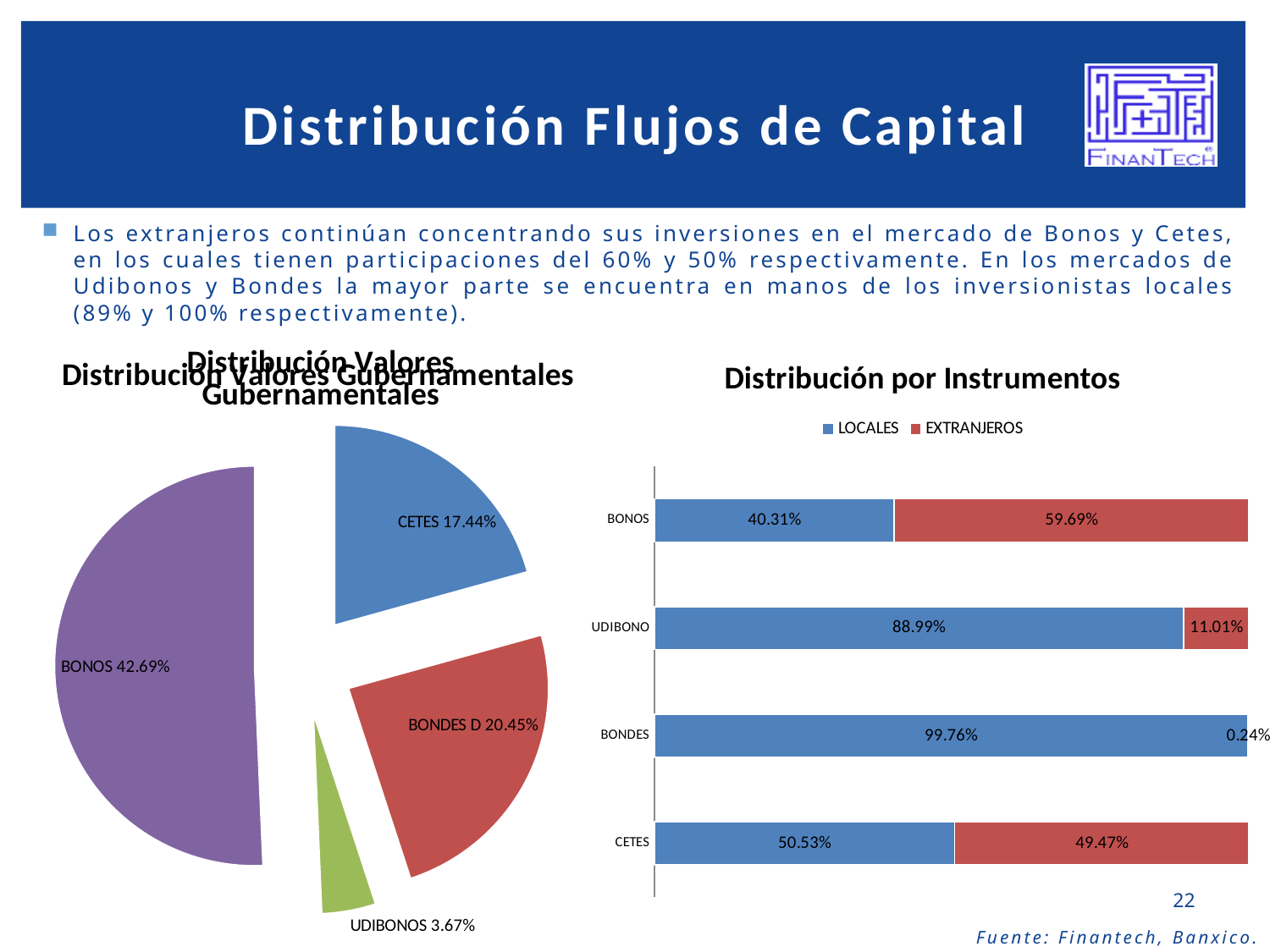
In the 'Distribución por Instrumentos' chart, which instrument has the highest LOCALES value? BONDES In the 'Distribución Valores Gubernamentales' pie chart, how many slices are there? 4 In the 'Distribución Valores Gubernamentales' pie chart, what is the difference between the BONDES D and CETES values? 3.01% In the 'Distribución por Instrumentos' chart, what is the LOCALES value for UDIBONO? 88.99% What kind of chart is 'Distribución por Instrumentos'? Stacked bar chart In the 'Distribución por Instrumentos' chart, how many series does the legend list? 2 In the 'Distribución Valores Gubernamentales' pie chart, which category has the largest slice? BONOS In the 'Distribución por Instrumentos' chart, which is larger for CETES: LOCALES or EXTRANJEROS? LOCALES In the 'Distribución por Instrumentos' chart, what is the EXTRANJEROS value for BONOS? 59.69% In the 'Distribución Valores Gubernamentales' pie chart, what is the value shown for BONOS? 42.69% In the 'Distribución por Instrumentos' chart, what is the total of the BONDES bar (LOCALES plus EXTRANJEROS)? 100% In the 'Distribución Valores Gubernamentales' pie chart, which category has the smallest slice? UDIBONOS